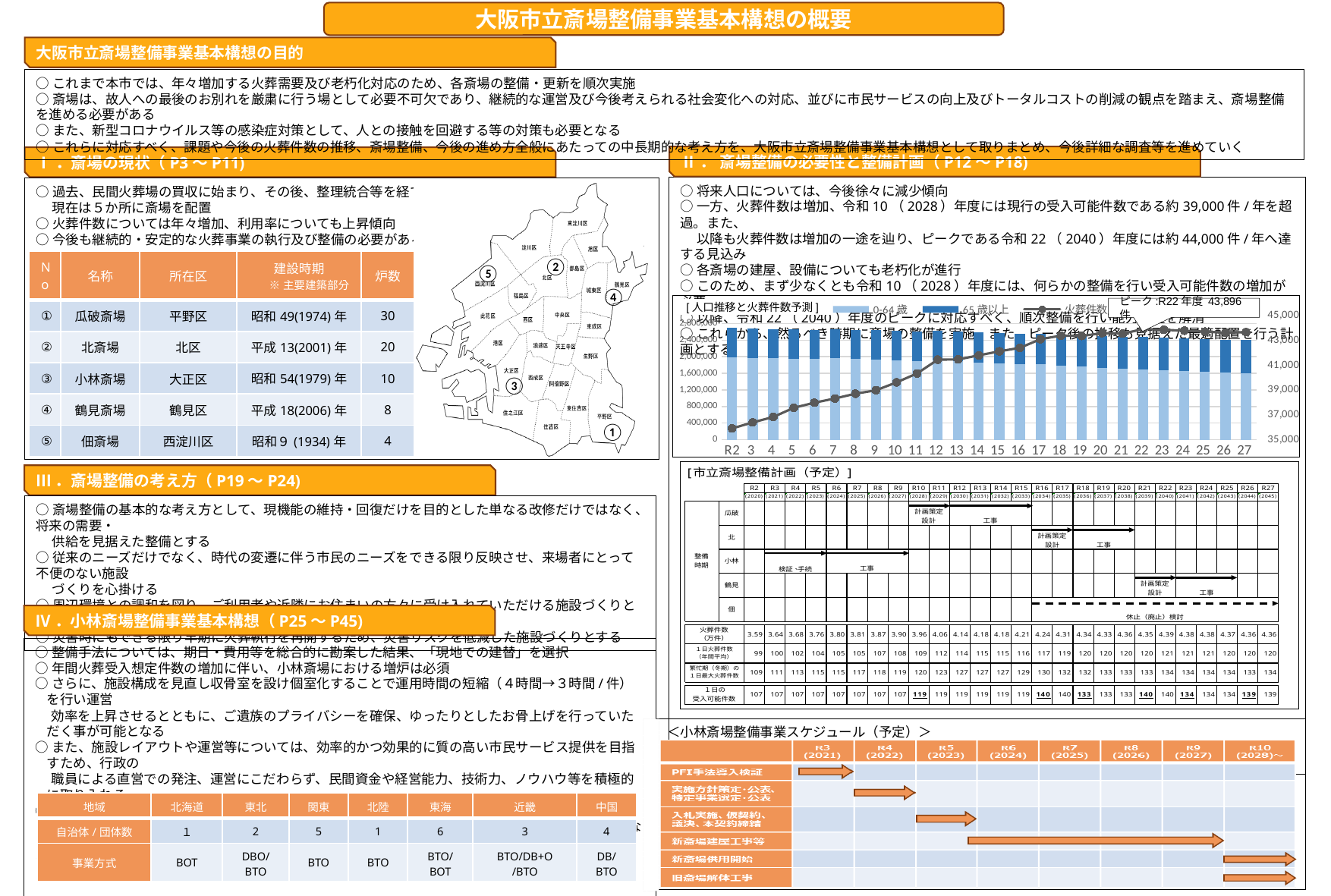
In the [人口推移と火葬件数予測] chart, which is larger, the 火葬件数 for R2 or for R17? R17 In the [人口推移と火葬件数予測] chart, does the 火葬件数 line rise or fall from R2 to R17? Rise In the [人口推移と火葬件数予測] chart, what is the peak value of 火葬件数 labelled on the chart? 43,896 How many series does the legend of the [人口推移と火葬件数予測] chart list? 3 In the [人口推移と火葬件数予測] chart, in which fiscal year does 火葬件数 reach its peak? R22年度 In the [人口推移と火葬件数予測] chart, is the 火葬件数 value for R2 greater or less than 37,000? less In the [人口推移と火葬件数予測] chart, is the total stacked population bar for R2 greater or less than 2,400,000? greater What are the legend entries of the [人口推移と火葬件数予測] chart? 0-64歳, 65歳以上, 火葬件数 What is the maximum value shown on the right-hand axis of the [人口推移と火葬件数予測] chart? 45,000 How many fiscal years are shown on the x axis of the [人口推移と火葬件数予測] chart? 26 What kind of chart is the [人口推移と火葬件数予測] chart? A combined bar and line chart In the [人口推移と火葬件数予測] chart, is the 火葬件数 value for R27 greater or less than 41,000? greater